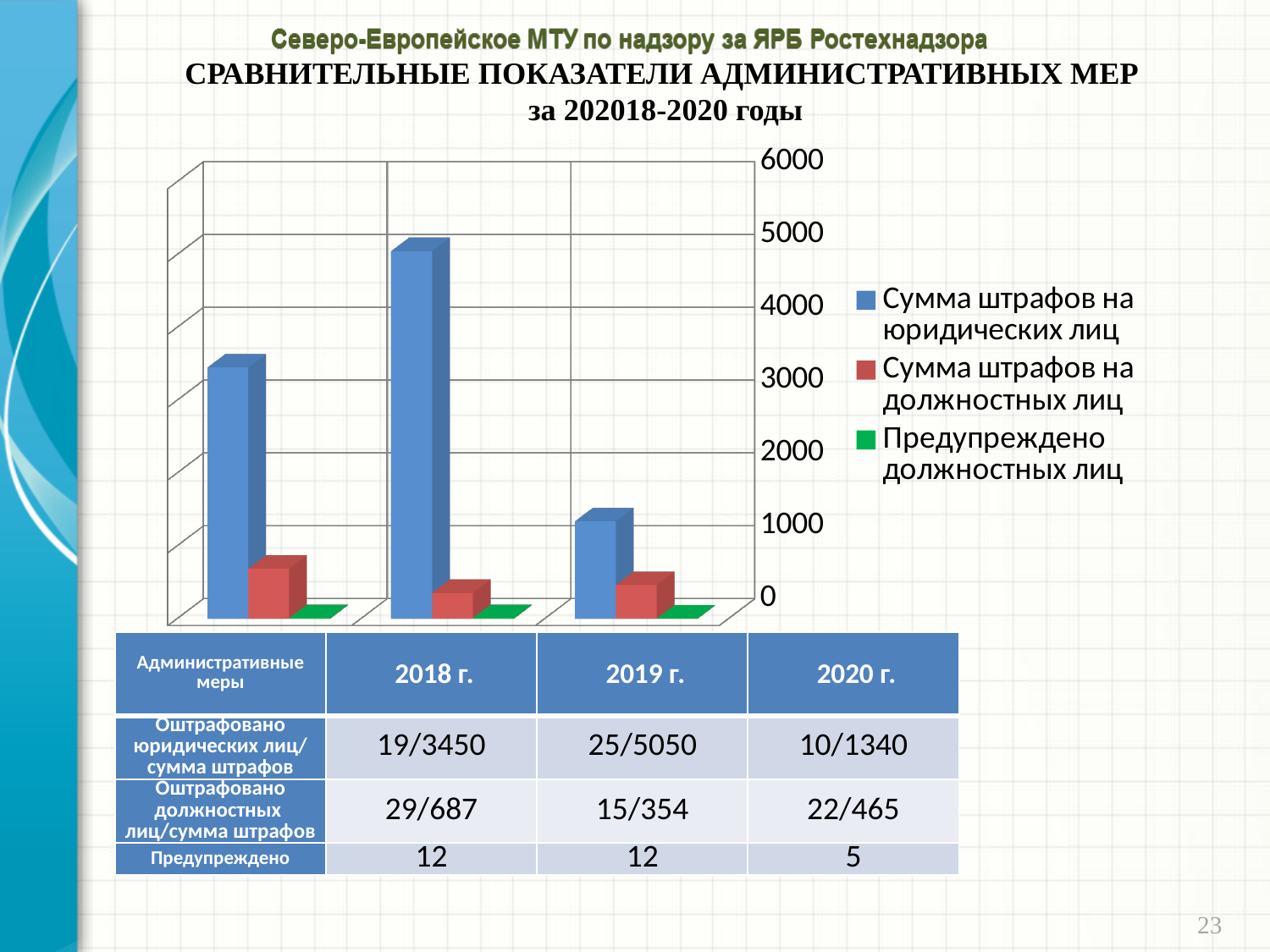
Which group of bars (left, middle or right) has the tallest blue bar for 'Сумма штрафов на юридических лиц'? middle Which is larger: the blue bar in the left group or the blue bar in the right group? left group Is the red bar in the left group greater or less than 1000? less How many groups of bars are plotted in the chart? 3 How many series does the chart legend list? 3 Is the blue bar in the left group greater or less than 3000? greater What kind of chart is shown on the slide? bar chart Is the blue bar in the middle group greater or less than 4000? greater What colour represents 'Предупреждено должностных лиц' in the legend? green Do the blue bars rise or fall from the middle group to the right group? fall Which group of bars (left, middle or right) has the shortest blue bar for 'Сумма штрафов на юридических лиц'? right